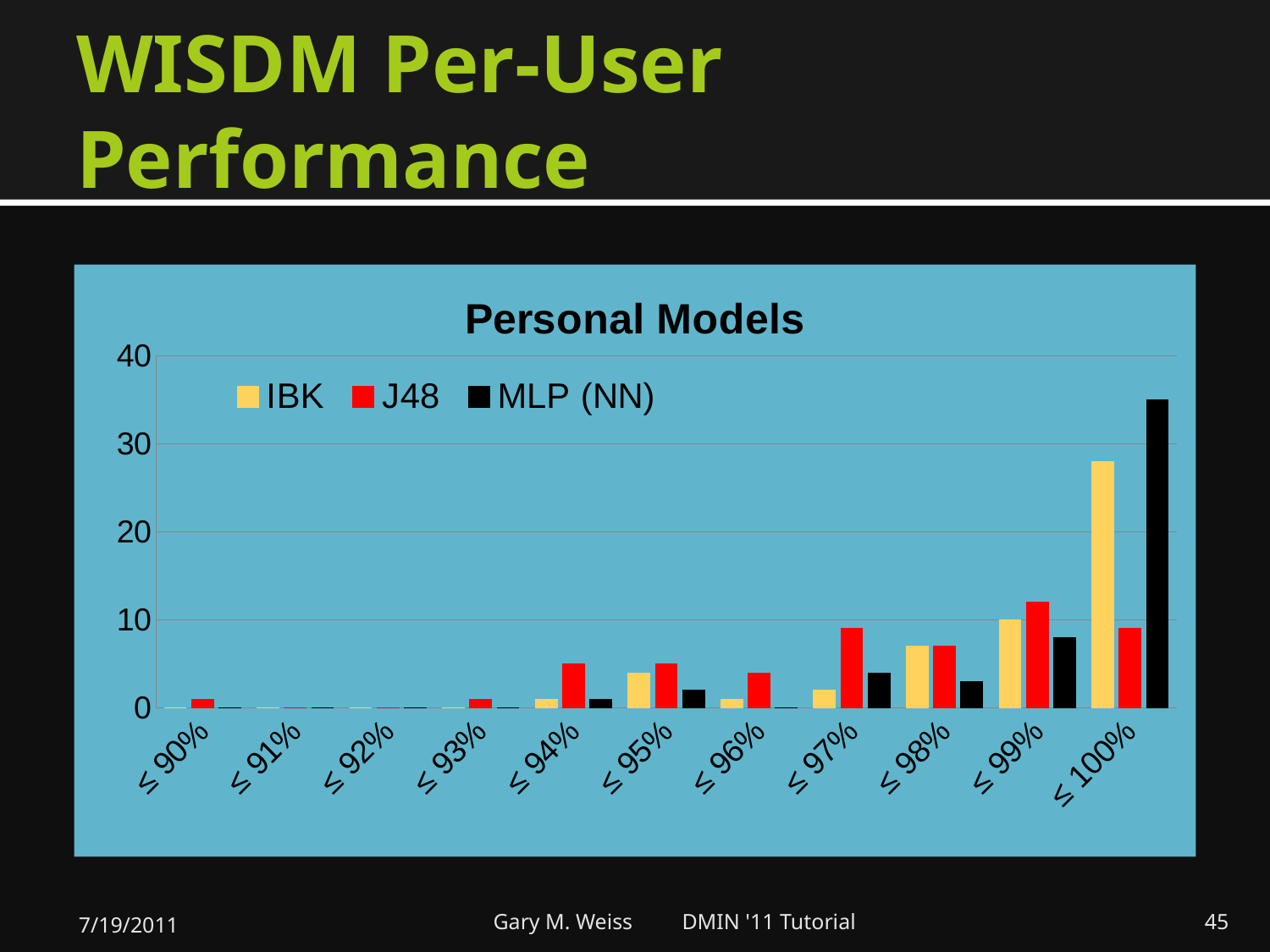
What kind of chart is shown on the slide? bar chart Which category contains the tallest bar in the chart? ≤ 100% Is the IBK value for ≤ 100% greater or less than 20? greater What is the title of the chart? Personal Models In the ≤ 97% category, which is larger, the IBK value or the J48 value? J48 How many series does the legend list? 3 How many categories are shown on the x axis? 11 Which series has the tallest bar in the ≤ 100% category? MLP (NN) Is the J48 value for ≤ 100% greater or less than 20? less Do the IBK values generally rise or fall moving from ≤ 90% to ≤ 100% along the x axis? rise Is the MLP (NN) value for ≤ 100% greater or less than 30? greater In the ≤ 100% category, which is larger, the IBK value or the J48 value? IBK